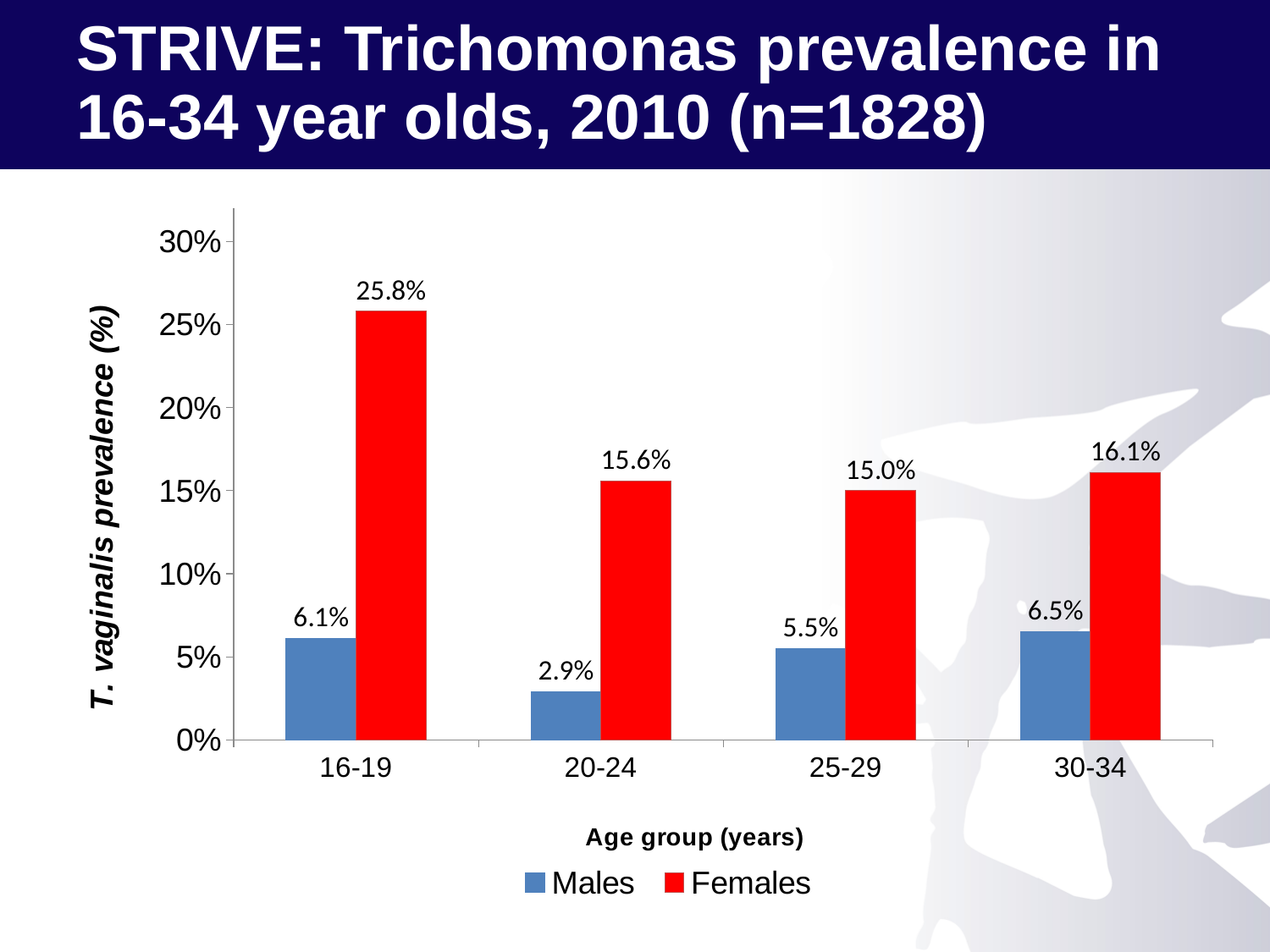
How many age groups are shown on the x axis? 4 Which age group has the highest female prevalence? 16-19 What is the T. vaginalis prevalence for females aged 30-34? 16.1% Which age group has the lowest male prevalence? 20-24 What is the difference between female and male prevalence in the 16-19 age group? 19.7% What is the T. vaginalis prevalence for females aged 16-19? 25.8% What colour are the bars for Females? Red Which is larger, the male prevalence for 25-29 or for 30-34? 30-34 Is the female prevalence for 20-24 greater or less than 10%? greater What is the T. vaginalis prevalence for males aged 20-24? 2.9% How many series does the legend list? 2 What kind of chart is shown on the slide? Bar chart